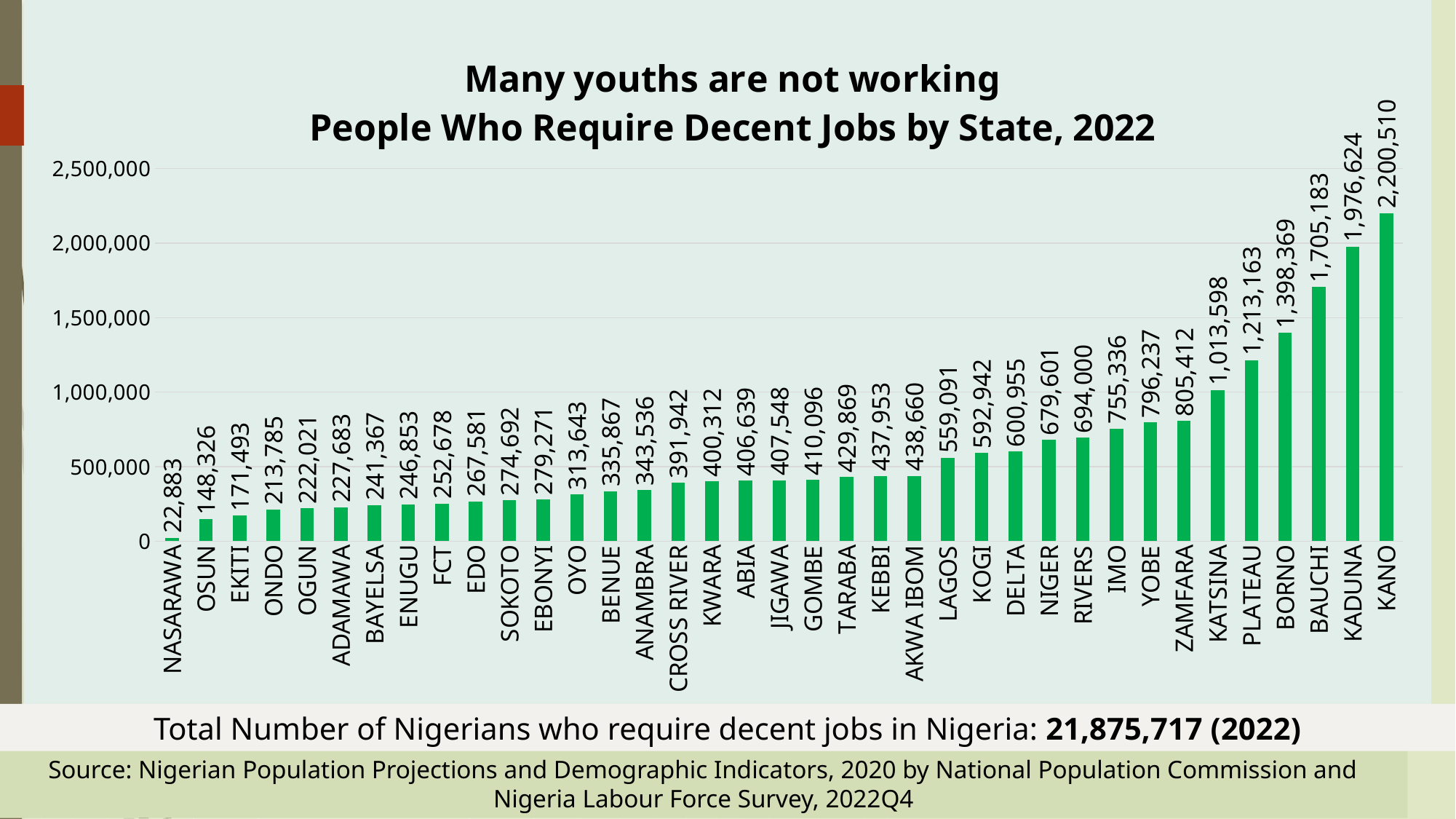
What is the value for Lagos? 559,091 How many states are shown on the chart? 37 Which state has the lowest value? Nasarawa What is the difference between the values for Kano and Kaduna? 223,886 What is the value for Kaduna? 1,976,624 What kind of chart is shown? bar chart Which is larger, the value for Rivers or the value for Niger? Rivers Do the values rise or fall from left to right along the x axis? rise Is the value for Katsina greater or less than 1,000,000? greater What is the value for Cross River? 391,942 Which state has the highest value? Kano What is the difference between the values for Lagos and Osun? 410,765